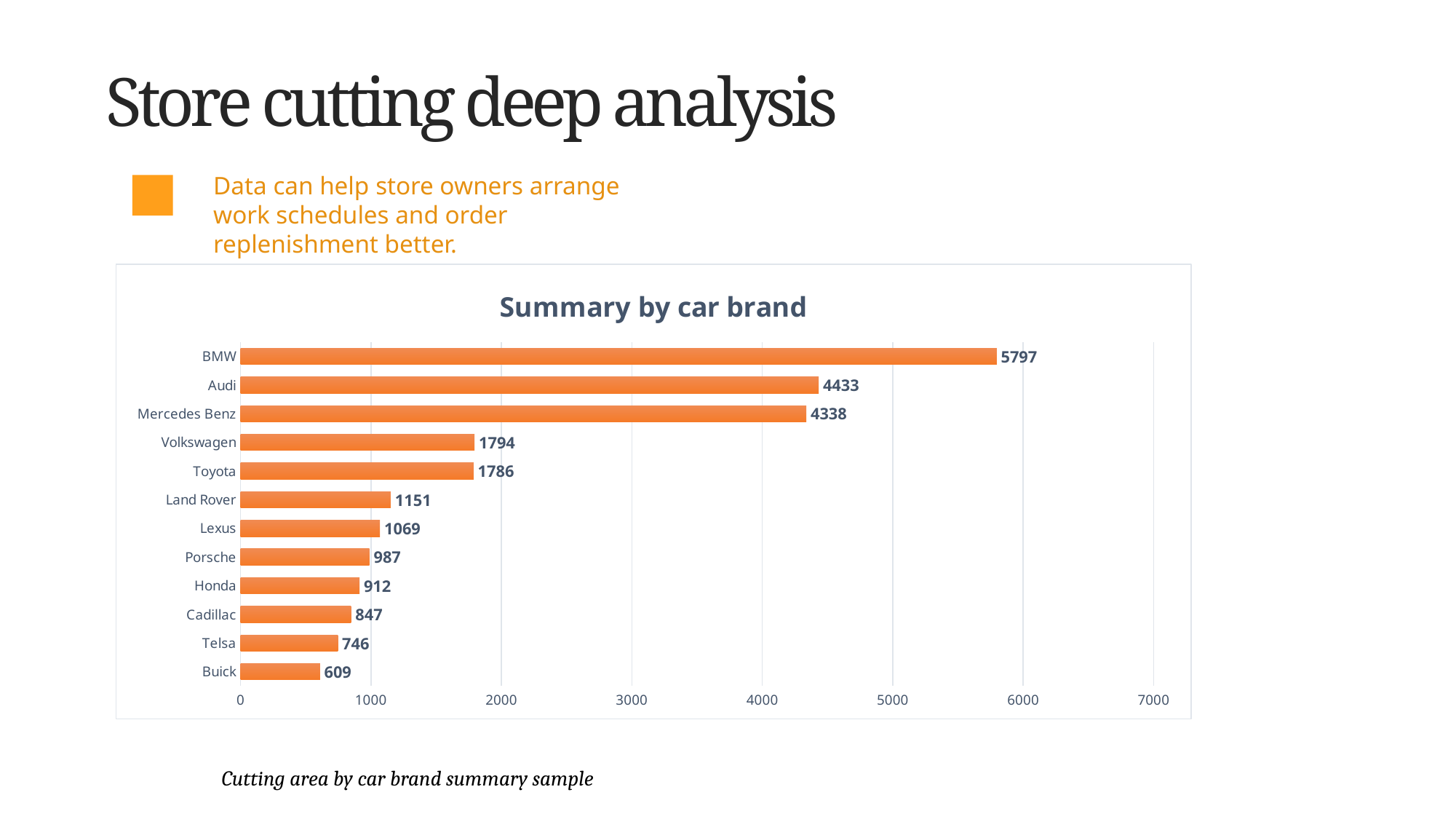
What kind of chart is shown on the slide? bar chart Which car brand has the highest value? BMW Which is larger, the value for Lexus or the value for Porsche? Lexus Which car brand has the lowest value? Buick What is the title of the chart? Summary by car brand Is the value for Mercedes Benz greater or less than 4000? greater How many car brands are shown in the chart? 12 What is the value for Telsa? 746 What is the difference between the values for BMW and Audi? 1364 What is the difference between the values for Honda and Cadillac? 65 What is the value for Land Rover? 1151 What is the value for BMW? 5797